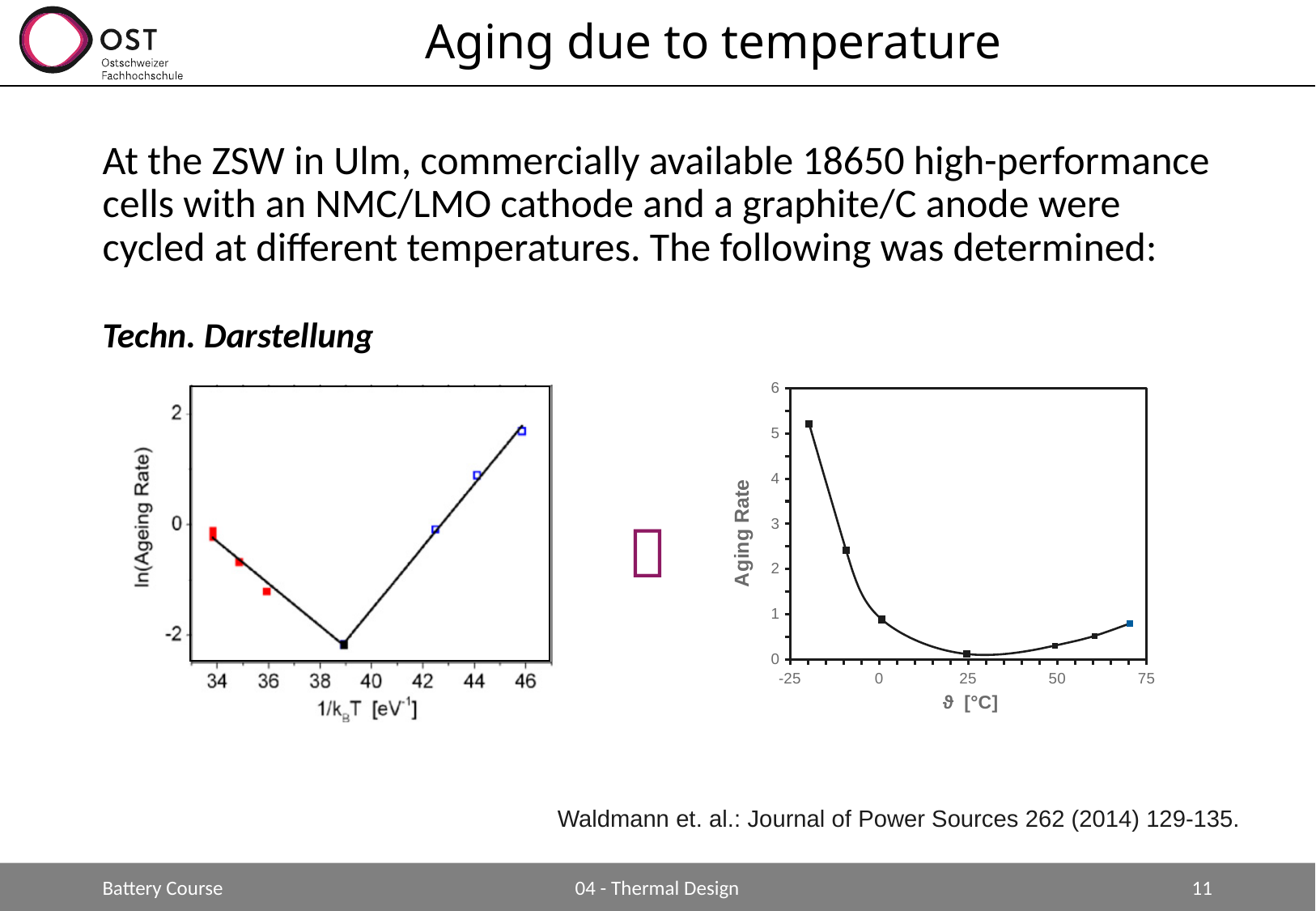
On the right-hand chart, is the aging rate at the leftmost point (about -20 °C) greater or less than 4? greater On the right-hand chart, which has the larger aging rate: 0 °C or 50 °C? 0 °C On the right-hand chart, does the aging rate rise or fall as temperature increases from 25 °C to 70 °C? rises On the right-hand chart, how many data points are plotted? 7 What kind of chart is the right-hand chart (Aging Rate vs temperature)? line chart On the right-hand chart, does the aging rate rise or fall as temperature increases from -20 °C to 25 °C? falls On the right-hand chart, at which temperature tick is the aging rate lowest? 25 °C On the left-hand chart, is ln(Ageing Rate) at 1/kBT = 46 eV⁻¹ greater or less than 1? greater On the right-hand chart, what is the label of the y-axis? Aging Rate On the right-hand chart, is the aging rate at 0 °C greater or less than 2? less On the left-hand chart, what is the label of the y-axis? ln(Ageing Rate)